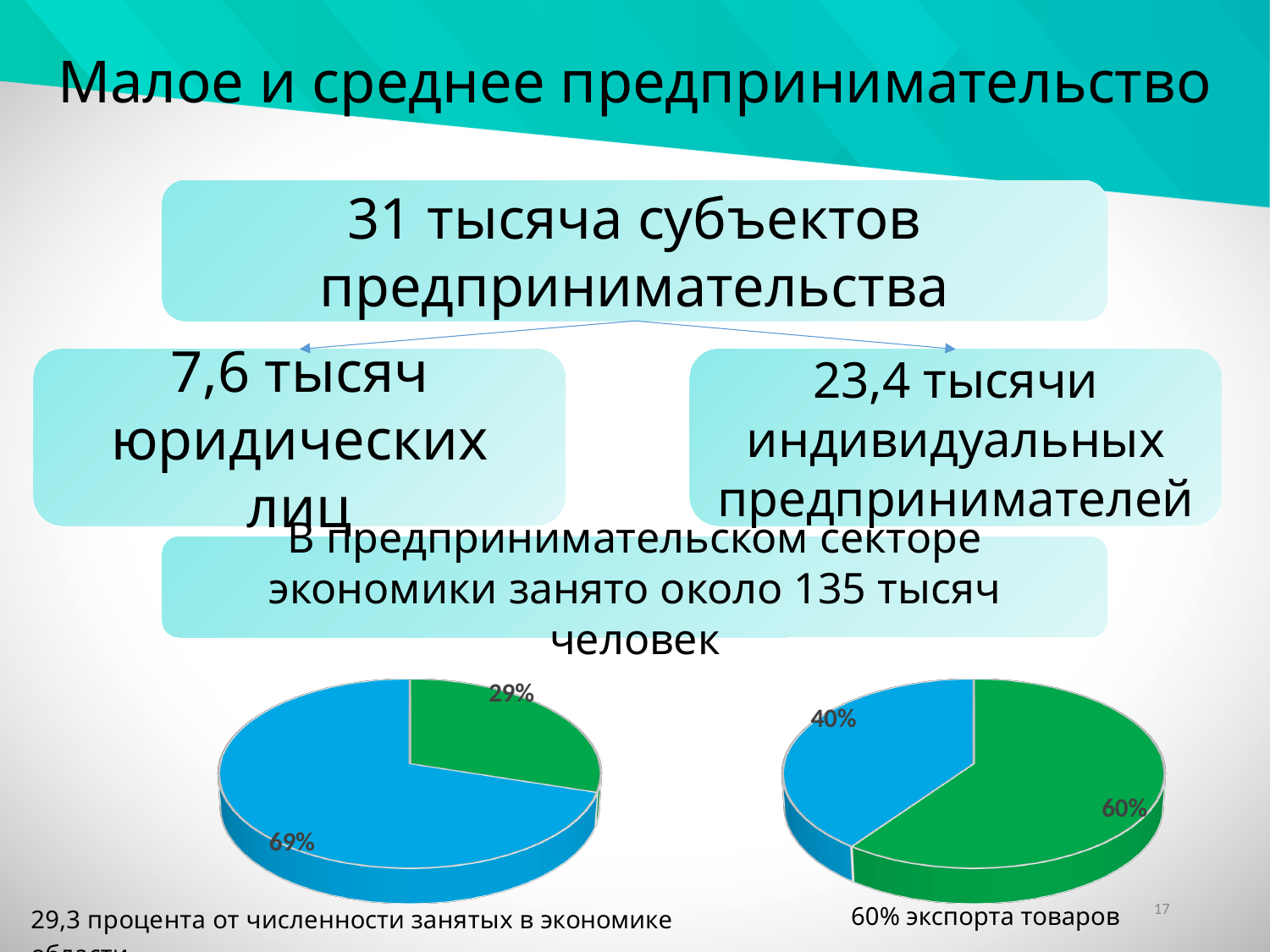
In the right pie chart, which slice is larger, the blue one or the green one? green How many slices does the left pie chart have? 2 In the right pie chart, what percentage is shown for the green slice? 60% In the right pie chart, what percentage is shown for the blue slice? 40% What kind of chart is shown at the bottom left of the slide? pie chart In the right pie chart, what is the difference in percentage points between the green slice and the blue slice? 20 What kind of chart is shown at the bottom right of the slide? pie chart In the left pie chart, what percentage is shown for the blue slice? 69% In the left pie chart, what percentage is shown for the green slice? 29% How many slices does the right pie chart have? 2 In the left pie chart, which slice is larger, the blue one or the green one? blue What colour is the largest slice in the right pie chart? green